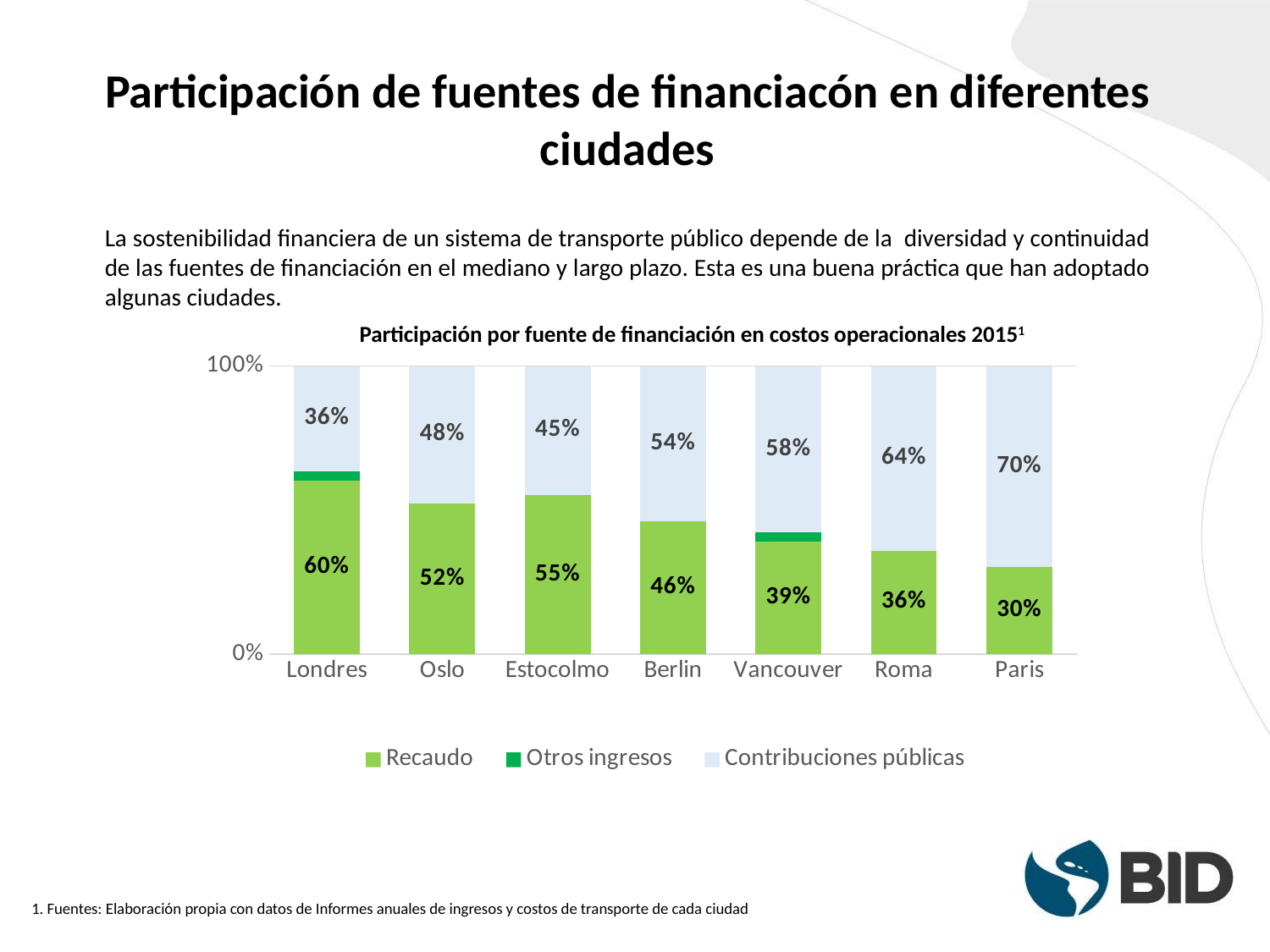
What is the Contribuciones públicas share for Berlin? 54% What is the difference between the Contribuciones públicas share for Roma and for Oslo? 16% What is the Recaudo share for Vancouver? 39% Does the Contribuciones públicas share generally rise or fall from Oslo to Paris? Rise What is the Contribuciones públicas share for Paris? 70% What is the Recaudo share for Londres? 60% Which is larger, the Recaudo share for Estocolmo or for Oslo? Estocolmo Which city has the highest Recaudo share? Londres What kind of chart is shown? Stacked bar chart How many cities are shown on the x axis? 7 How many series does the legend list? 3 Which city has the lowest Contribuciones públicas share? Londres